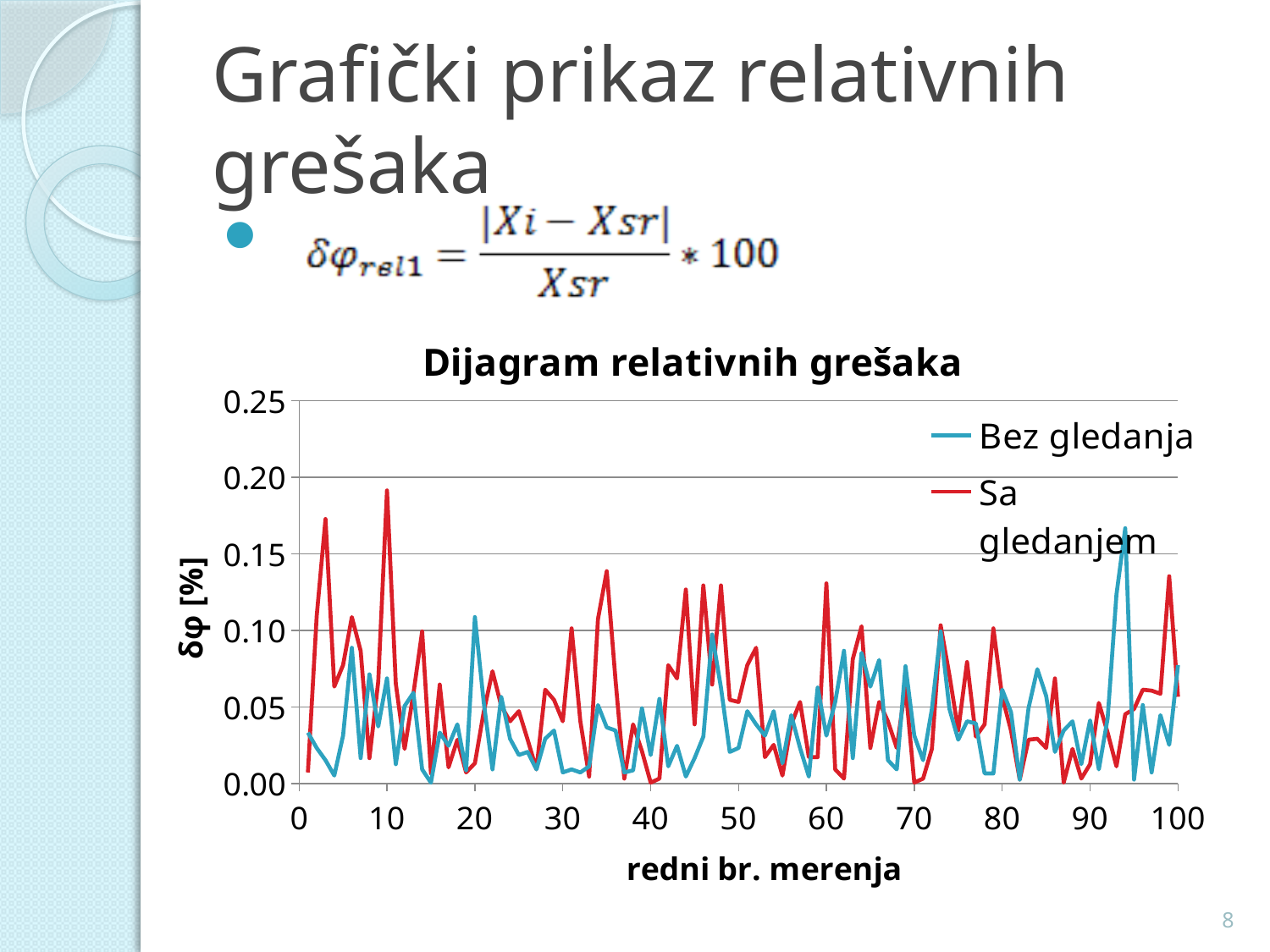
How many series does the legend of the chart list? 2 What is the title of the chart? Dijagram relativnih grešaka Is the value of the 'Bez gledanja' series at measurement 10 greater or less than 0.10? less Which series reaches the highest peak in the chart, 'Bez gledanja' or 'Sa gledanjem'? Sa gledanjem What kind of chart is shown on the slide? line chart Is the highest value of the 'Sa gledanjem' series greater or less than 0.15? greater Is the highest value of the 'Bez gledanja' series greater or less than 0.15? greater What is the maximum value shown on the y axis of the chart? 0.25 What is the label of the x axis of the chart? redni br. merenja Which series is drawn in red in the chart? Sa gledanjem